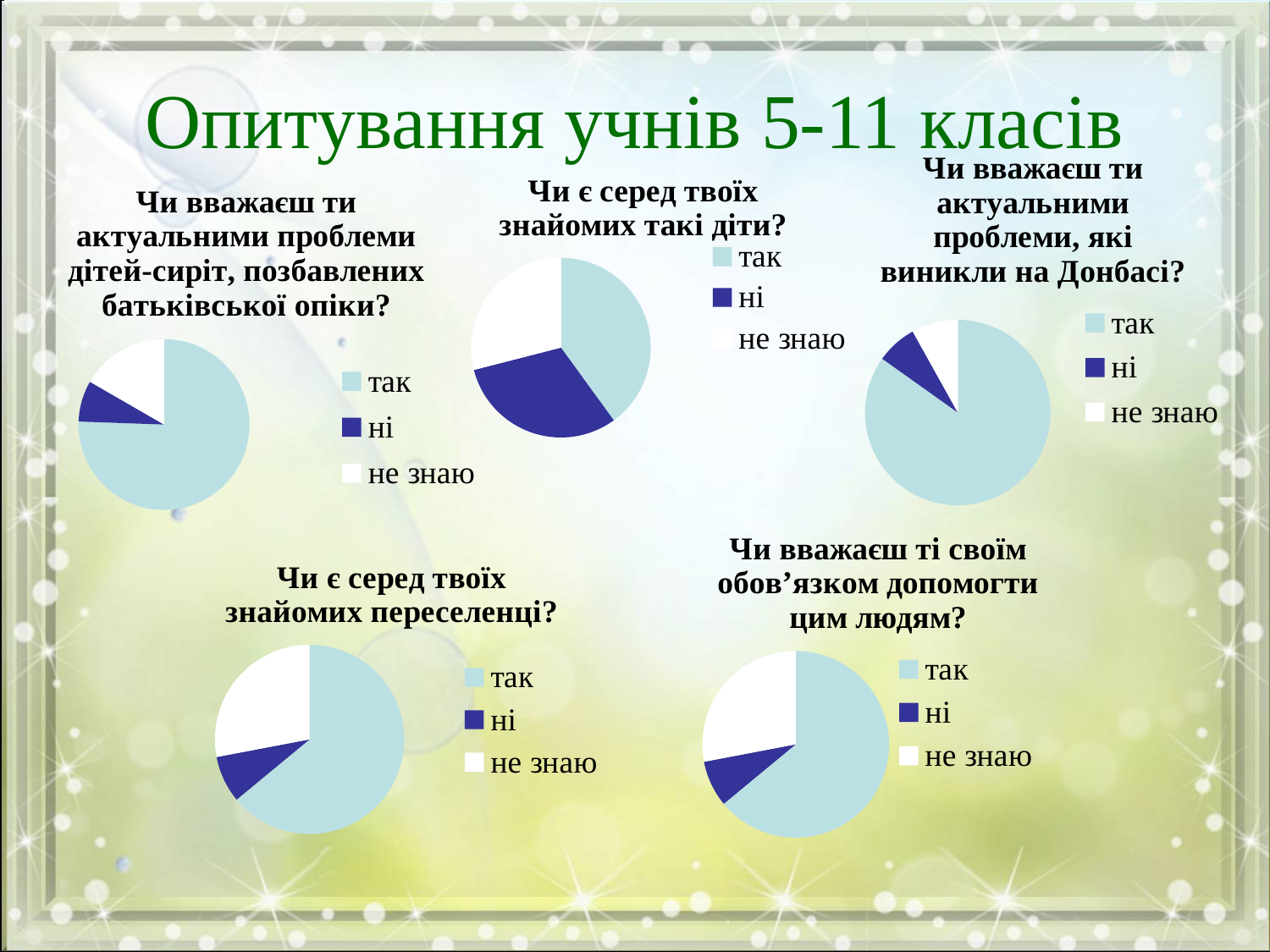
In the chart "Чи є серед твоїх знайомих такі діти?", which answer has the largest slice? так How many pie charts are shown on the slide? 5 In the chart "Чи вважаєш ти актуальними проблеми дітей-сиріт, позбавлених батьківської опіки?", which answer has the smallest slice? ні In the chart "Чи вважаєш ти актуальними проблеми дітей-сиріт, позбавлених батьківської опіки?", which answer has the largest slice? так In the chart "Чи є серед твоїх знайомих переселенці?", which slice is larger: "ні" or "так"? так In the chart "Чи вважаєш ті своїм обов’язком допомогти цим людям?", which answer has the largest slice? так In the chart "Чи вважаєш ти актуальними проблеми дітей-сиріт, позбавлених батьківської опіки?", how many entries does the legend list? 3 What kind of chart is used for the question "Чи є серед твоїх знайомих переселенці?"? pie chart What colour represents the answer "ні" in the pie charts on the slide? dark blue In the chart "Чи є серед твоїх знайомих такі діти?", which slice is larger: "так" or "не знаю"? так In the chart "Чи вважаєш ті своїм обов’язком допомогти цим людям?", which slice is larger: "ні" or "так"? так